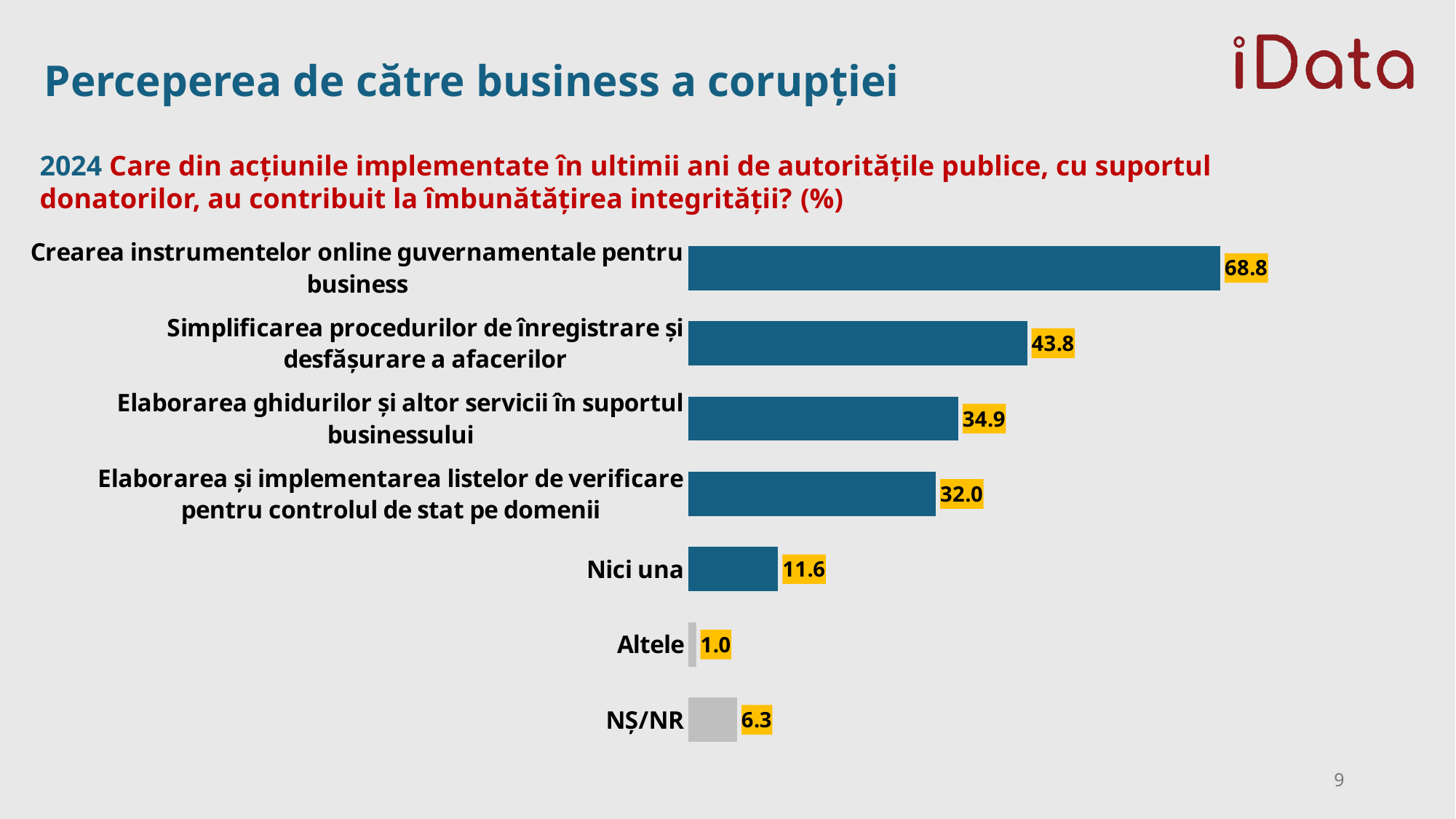
How many categories are shown in the chart? 7 What is the difference between the values for "Elaborarea ghidurilor și altor servicii în suportul businessului" and "Elaborarea și implementarea listelor de verificare pentru controlul de stat pe domenii"? 2.9 What colour are the bars for "Altele" and "NȘ/NR"? Grey What is the value for "NȘ/NR"? 6.3 Which category has the highest value? Crearea instrumentelor online guvernamentale pentru business Which is larger: the value for "Nici una" or the value for "NȘ/NR"? Nici una What is the difference between the values for "Crearea instrumentelor online guvernamentale pentru business" and "Simplificarea procedurilor de înregistrare și desfășurare a afacerilor"? 25.0 Which category has the lowest value? Altele What is the value for "Simplificarea procedurilor de înregistrare și desfășurare a afacerilor"? 43.8 What is the value for "Crearea instrumentelor online guvernamentale pentru business"? 68.8 What is the value for "Nici una"? 11.6 What kind of chart is shown on the slide? Bar chart